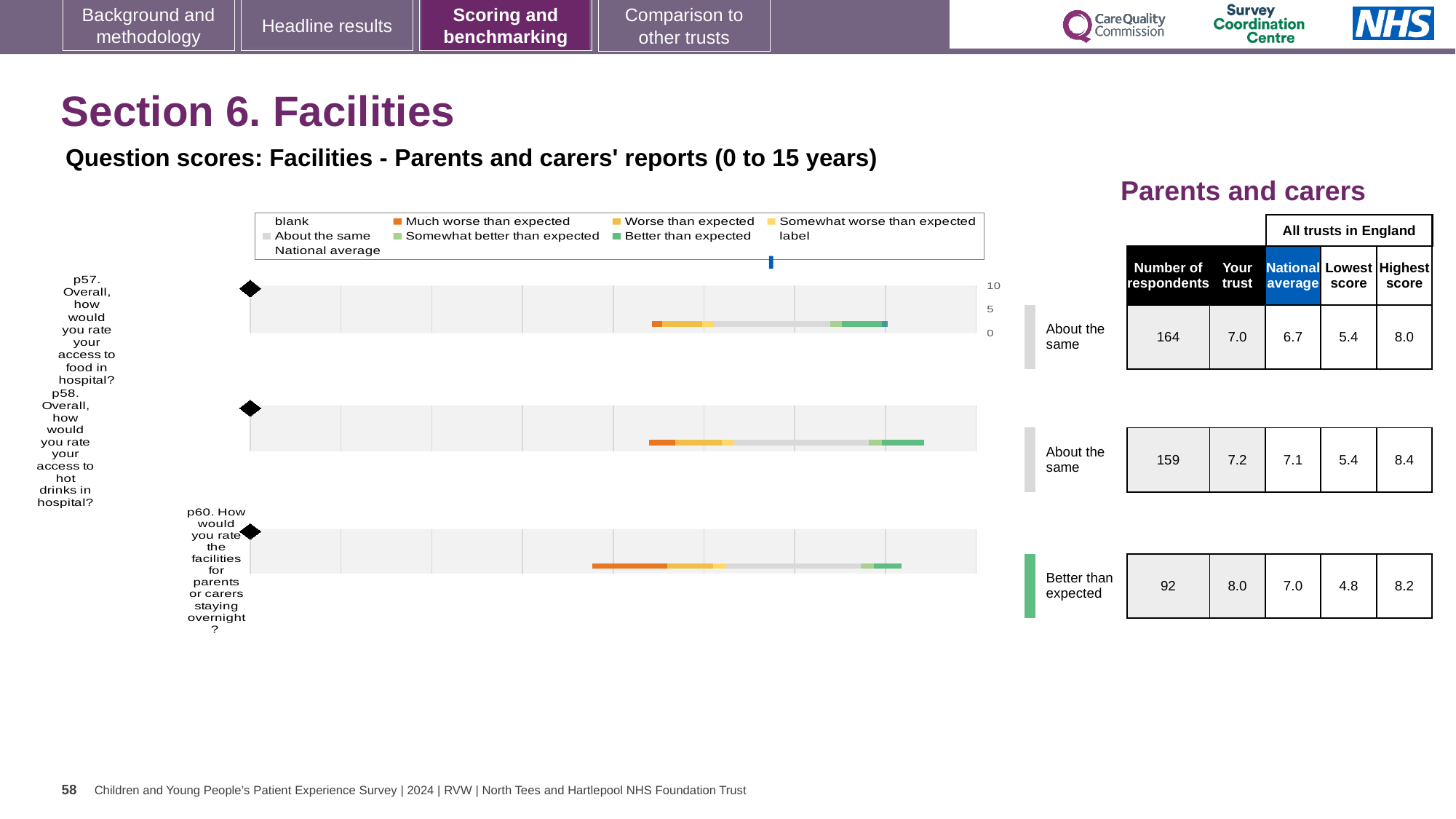
Which question has the highest 'Your trust' score? p60 Is the 'Your trust' score for p57 greater or less than 5? greater How many respondents answered p60 (facilities for parents or carers staying overnight)? 92 Which question is rated 'Better than expected'? p60 What is the 'Your trust' score for p57 (access to food in hospital)? 7.0 Which question has the lowest 'Your trust' score? p57 For p58, which is larger: the 'Your trust' score or the national average? Your trust How many questions (categories) are plotted in the Facilities chart? 3 What is the national average score for p58 (access to hot drinks in hospital)? 7.1 What kind of chart is used to show the question scores for Facilities? bar chart What is the highest score among all trusts in England for p58? 8.4 What is the difference between the 'Your trust' score and the national average for p60? 1.0